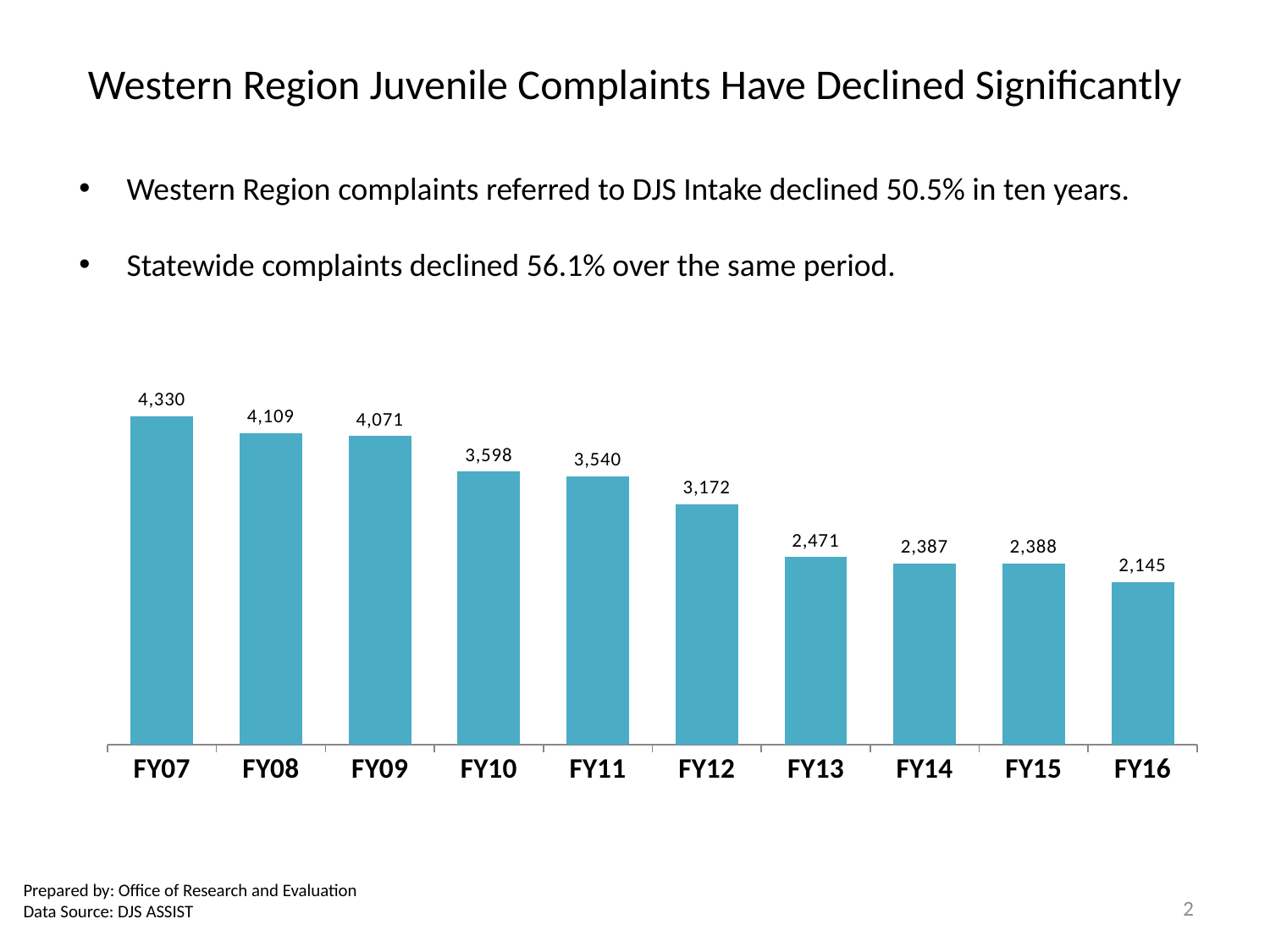
How many fiscal years are shown on the x axis? 10 What is the value for FY07? 4,330 What colour are the bars in the chart? Blue What is the difference between the values for FY07 and FY16? 2,185 What is the difference between the values for FY12 and FY13? 701 What is the value for FY16? 2,145 What is the value for FY12? 3,172 Which fiscal year has the highest value? FY07 Which is larger, the value for FY10 or the value for FY13? FY10 Which fiscal year has the lowest value? FY16 What kind of chart is shown on the slide? Bar chart Do the values generally rise or fall from FY07 to FY16? Fall